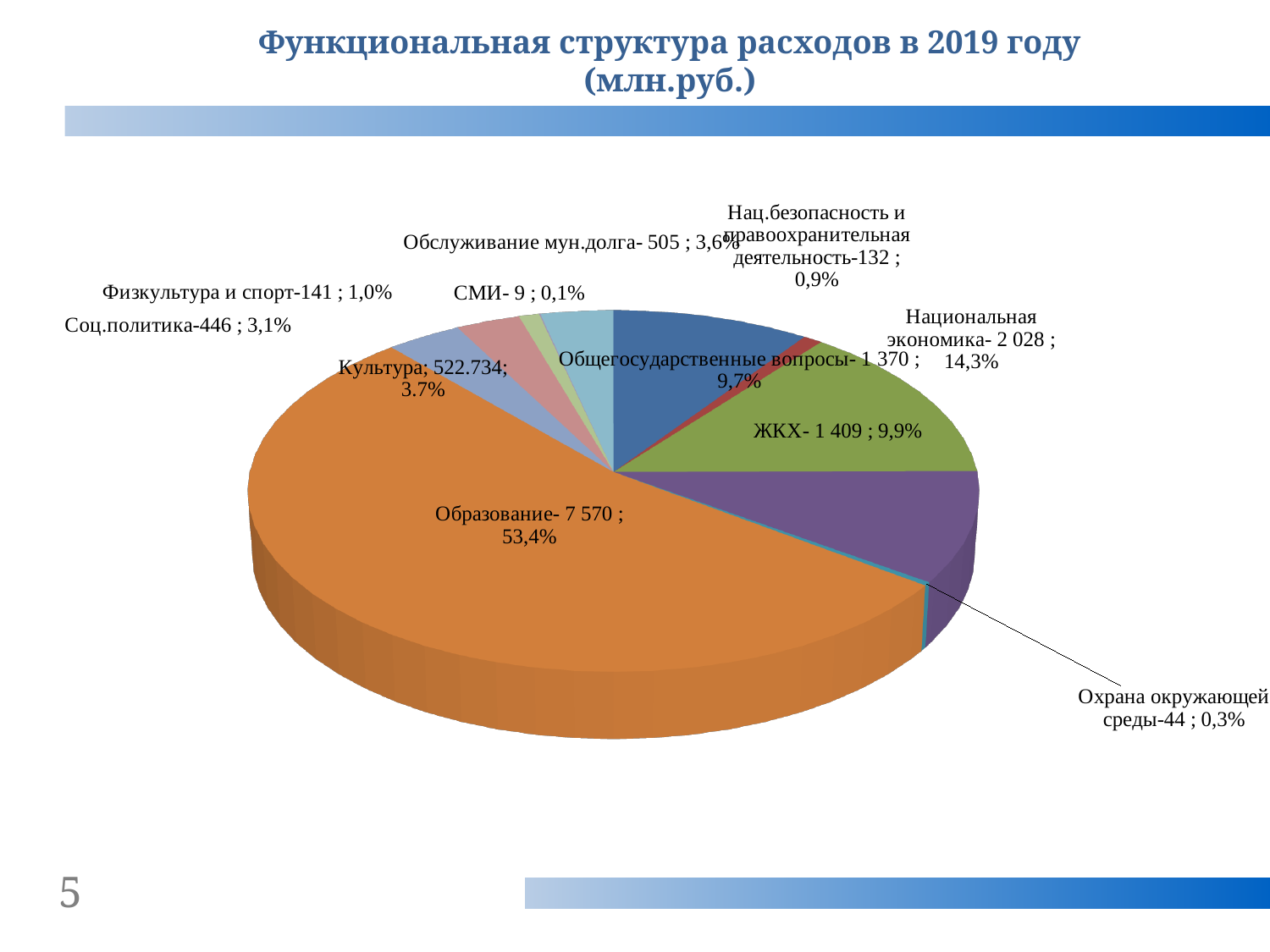
What is the value for Национальная экономика? 2 028 What is the difference between the values for Национальная экономика and ЖКХ? 619 What is the value for Охрана окружающей среды? 44 What kind of chart is shown on the slide? Pie chart What share of the pie does Образование represent? 53,4% What is the value for Образование? 7 570 How many categories are shown in the pie chart? 11 Which category has the largest slice of the pie? Образование What share of the pie does ЖКХ represent? 9,9% What is the title of the chart? Функциональная структура расходов в 2019 году (млн.руб.) Which is larger, the value for Соц.политика or the value for Обслуживание мун.долга? Обслуживание мун.долга Which category has the smallest slice of the pie? СМИ